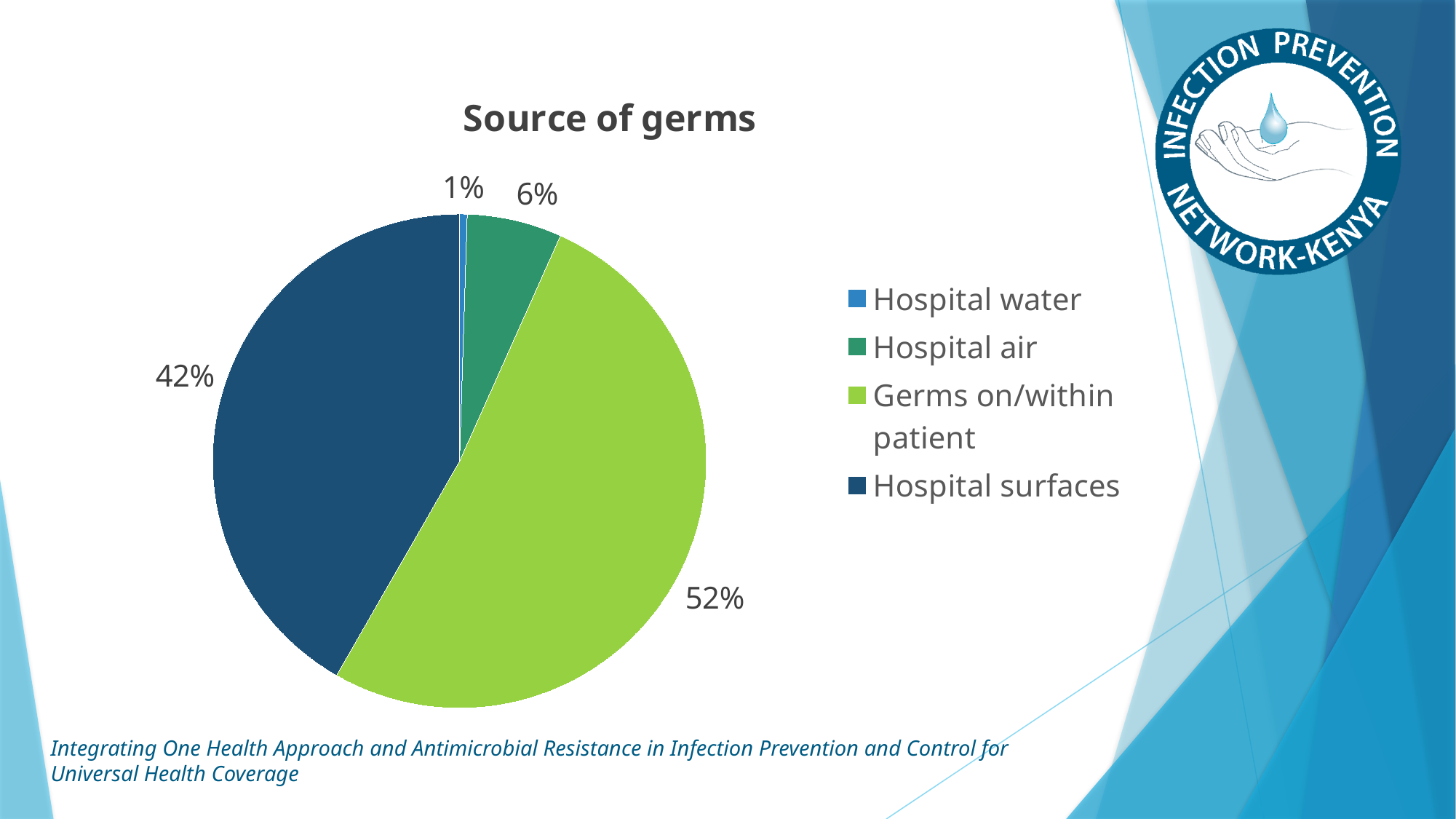
What is the difference between the shares for Hospital air and Hospital water? 5% Which is larger, the share for Hospital surfaces or the share for Hospital air? Hospital surfaces Which source of germs has the smallest share? Hospital water What is the value for Hospital air? 6% What is the title of the chart? Source of germs What is the value for Hospital surfaces? 42% What is the value for Hospital water? 1% Which source of germs has the largest share? Germs on/within patient What is the difference between the shares for Germs on/within patient and Hospital surfaces? 10% What kind of chart is shown on the slide? Pie chart How many categories does the pie chart show? 4 What share of the pie does Germs on/within patient account for? 52%